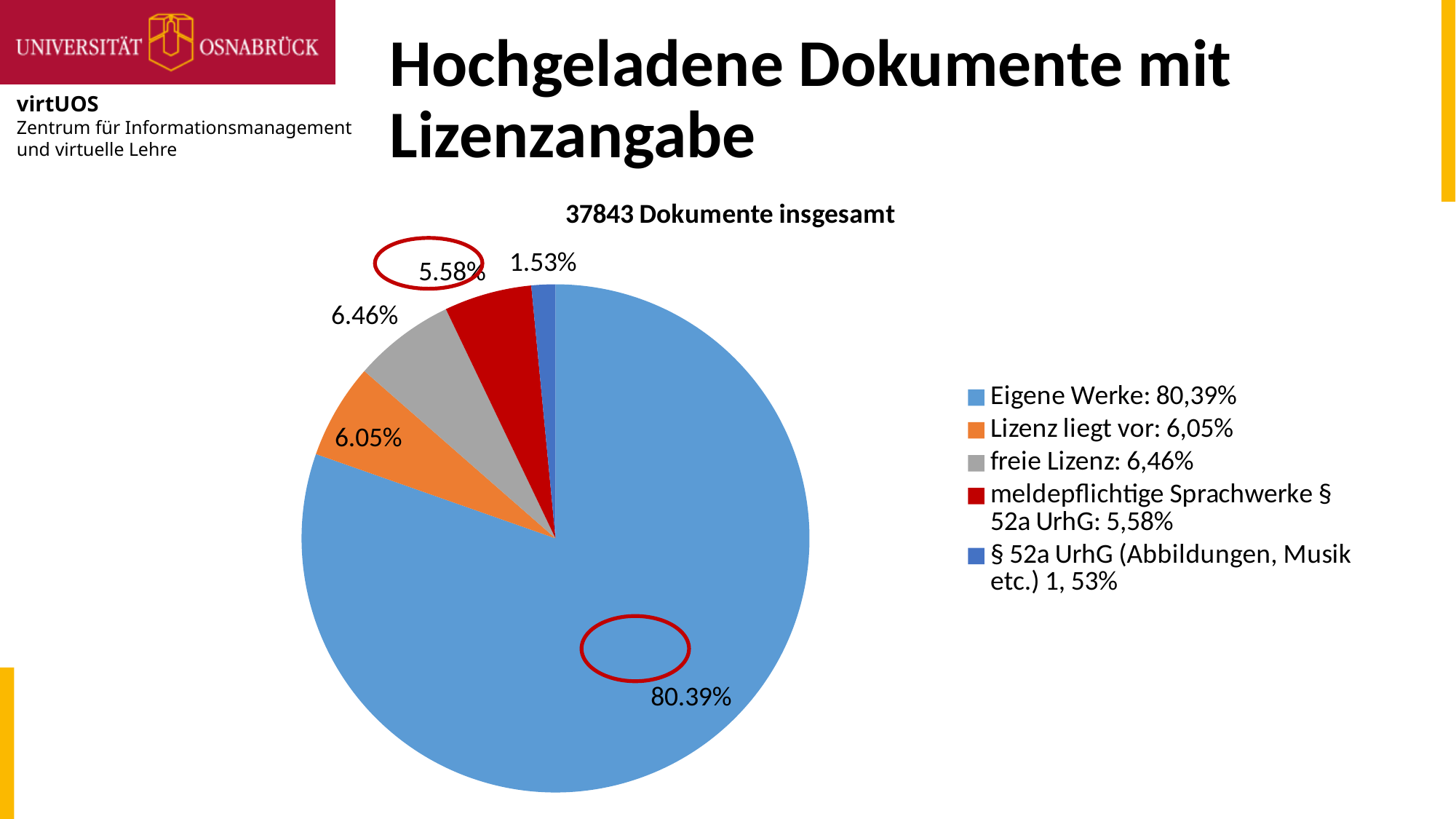
What colour is the slice for meldepflichtige Sprachwerke § 52a UrhG? red What share of the pie is labelled for Lizenz liegt vor? 6.05% Which category has the largest slice of the pie? Eigene Werke How many slices does the pie chart have? 5 What share of the pie is labelled for Eigene Werke? 80.39% What is the title of the pie chart? 37843 Dokumente insgesamt What share of the pie is labelled for meldepflichtige Sprachwerke § 52a UrhG? 5.58% Which slice is larger: freie Lizenz or Lizenz liegt vor? freie Lizenz What kind of chart is shown on the slide? pie chart Which category has the smallest slice of the pie? § 52a UrhG (Abbildungen, Musik etc.)